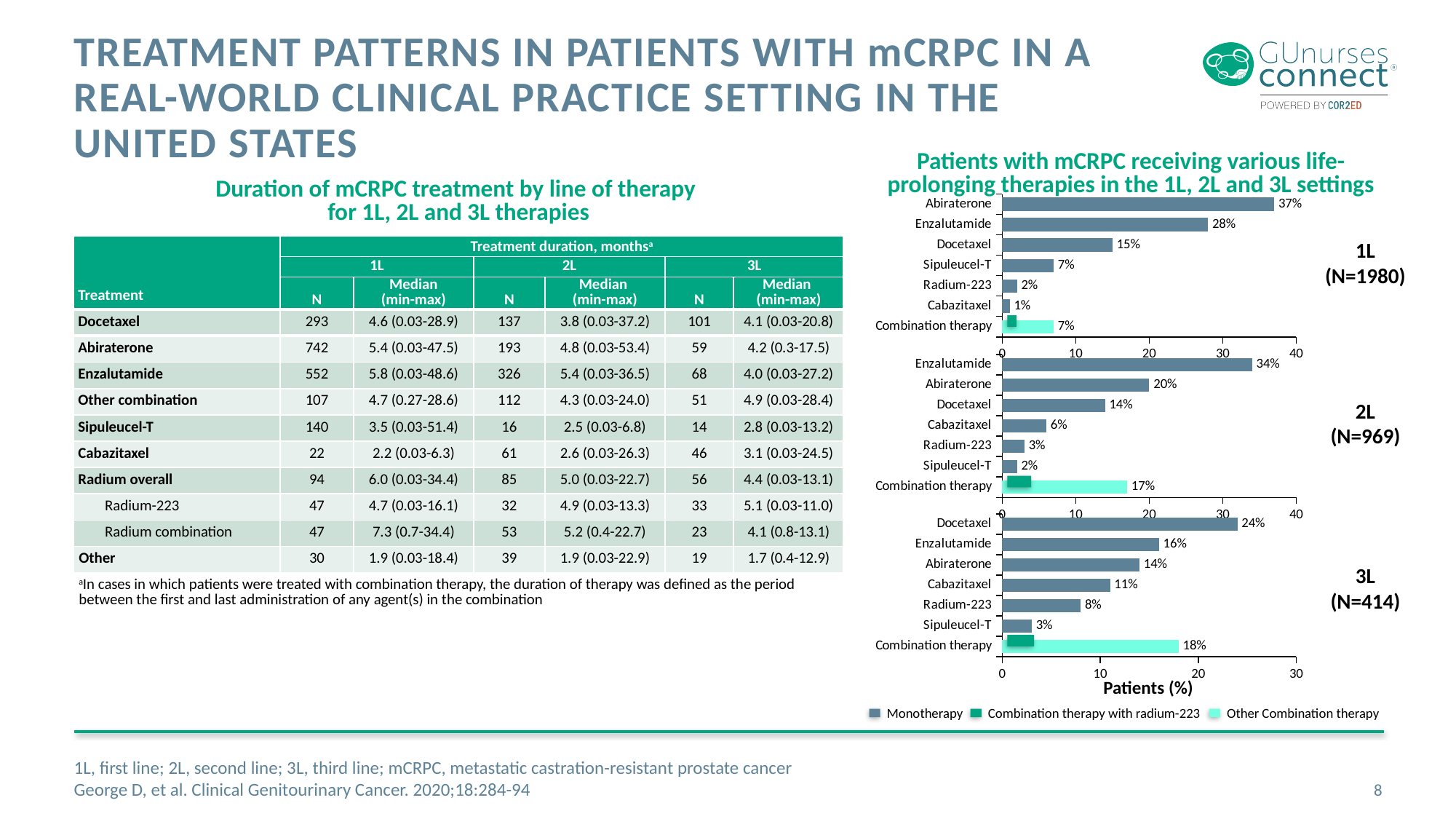
In the 3L chart, which is larger: the percentage for cabazitaxel or for radium-223? Cabazitaxel In the 1L chart, which therapy has the lowest percentage of patients? Cabazitaxel How many series does the legend of the bar charts list? 3 In the 1L chart, is the value for enzalutamide greater or less than 20? greater In the 3L chart, what percentage of patients received combination therapy? 18% In the 2L chart, what percentage of patients received enzalutamide? 34% What is the number of patients (N) shown for the 2L chart? N=969 In the 3L chart, which therapy has the highest percentage of patients? Docetaxel In the 1L chart, what percentage of patients received abiraterone? 37% What type of chart is used to show patients receiving life-prolonging therapies in the 1L, 2L and 3L settings? Bar chart How many therapy categories are shown in the 2L chart? 7 In the 2L chart, what is the difference in percentage points between abiraterone and docetaxel? 6